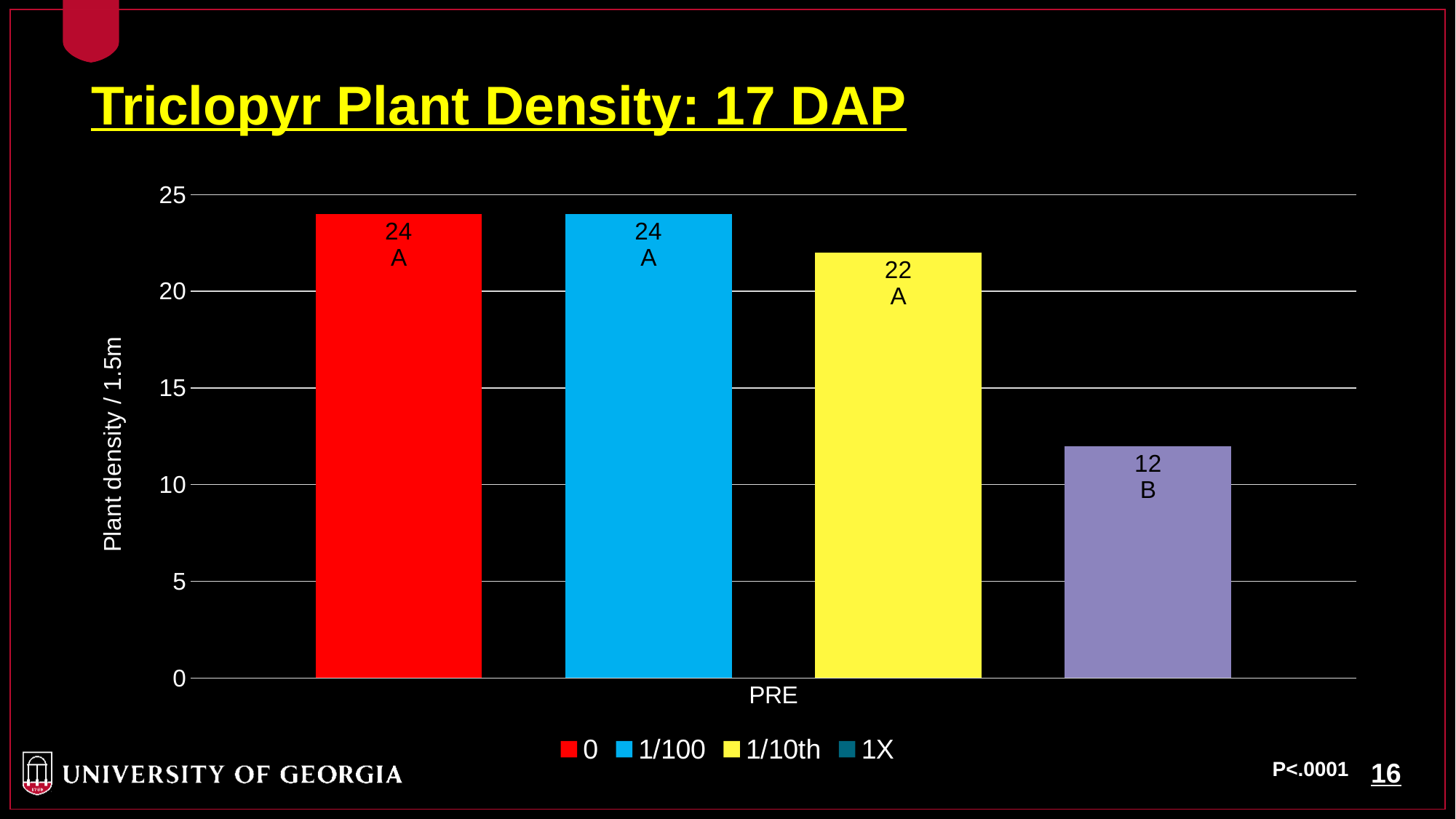
What kind of chart is shown on the slide? bar chart What is the difference in plant density between the 0 rate and the 1/10th rate? 2 Which rate has the lowest plant density? 1X What is the plant density value for the 1/100 rate? 24 What is the plant density value shown on the fourth (rightmost) bar? 12 Which is larger, the plant density for 1/100 or for 1/10th? 1/100 What is the plant density value for the 1/10th rate? 22 How many series does the legend list? 4 Is the plant density for the 1X rate greater or less than 15? less What is the difference in plant density between the 1/10th rate and the 1X rate? 10 What is the plant density value for the 0 rate in the PRE category? 24 What is the title of the chart on the slide? Triclopyr Plant Density: 17 DAP